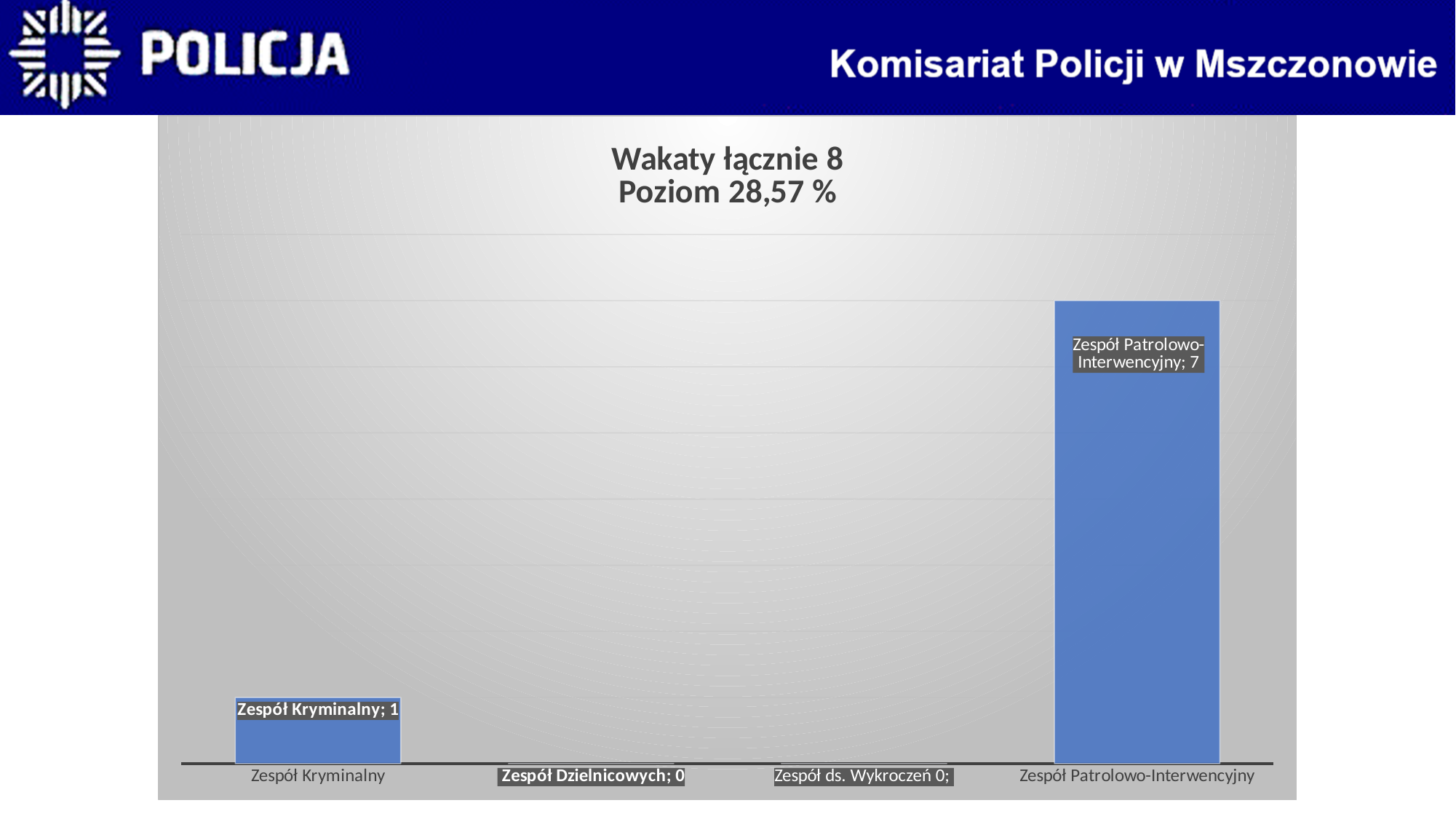
What is the value for Zespół ds. Wykroczeń? 0 How many categories are shown on the x axis? 4 What is the value for Zespół Patrolowo-Interwencyjny? 7 What is the title of the chart? Wakaty łącznie 8 Poziom 28,57 % What is the difference between the values for Zespół Patrolowo-Interwencyjny and Zespół Kryminalny? 6 How many categories have a value of 0? 2 Which category has the highest value? Zespół Patrolowo-Interwencyjny What is the value for Zespół Kryminalny? 1 What is the value for Zespół Dzielnicowych? 0 Which is larger, the value for Zespół Kryminalny or the value for Zespół Patrolowo-Interwencyjny? Zespół Patrolowo-Interwencyjny What is the total of all the plotted values? 8 What kind of chart is shown on the slide? bar chart